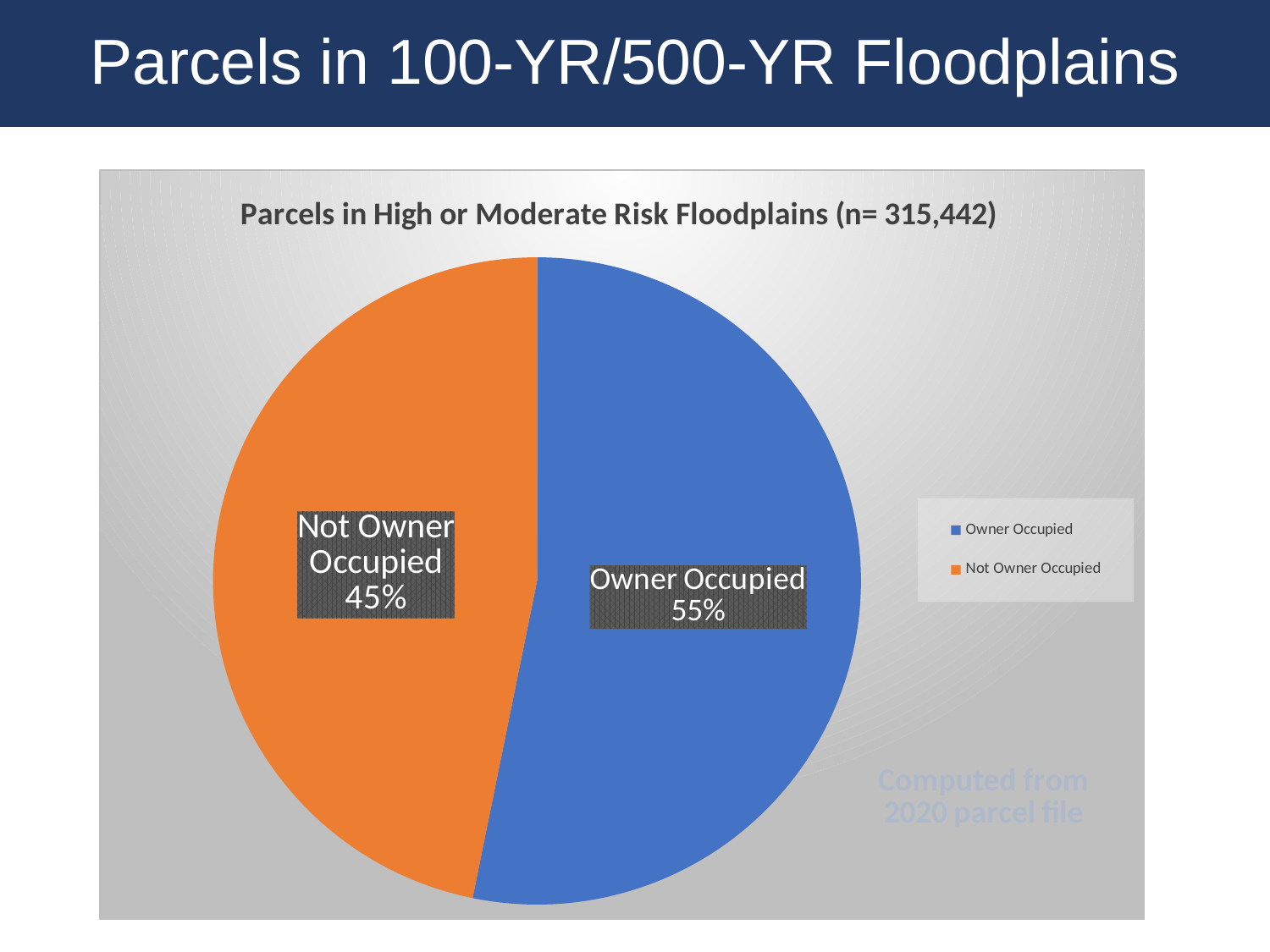
What is the difference in percentage points between the Owner Occupied and Not Owner Occupied shares? 10 percentage points What share of parcels in high or moderate risk floodplains is Not Owner Occupied? 45% What share of parcels in high or moderate risk floodplains is Owner Occupied? 55% Which category has the smaller share of the pie? Not Owner Occupied How many slices does the pie chart have? 2 How many entries does the legend list? 2 Which category has the larger share of the pie? Owner Occupied What is the total number of parcels (n) given in the chart title? 315,442 Which colour represents Not Owner Occupied in the pie chart? orange What kind of chart is shown on the slide? pie chart Is the share for Owner Occupied larger or smaller than the share for Not Owner Occupied? larger What is the title of the chart? Parcels in High or Moderate Risk Floodplains (n= 315,442)